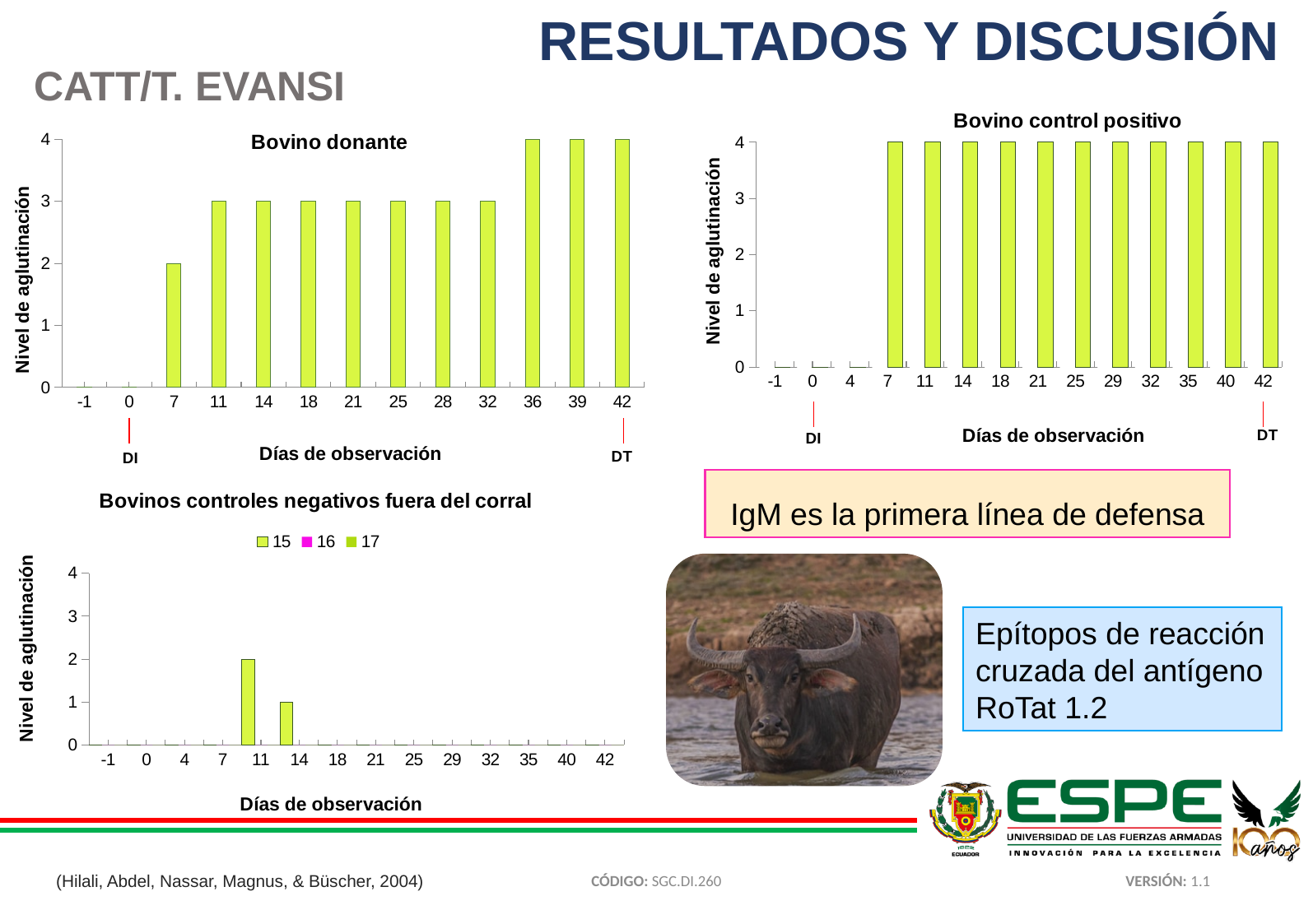
What kind of chart is 'Bovino control positivo'? Bar chart How many series does the legend of the 'Bovinos controles negativos fuera del corral' chart list? 3 In the 'Bovino donante' chart, do the agglutination levels rise or fall over the observation days? Rise In the 'Bovino control positivo' chart, what is the agglutination level on day 4? 0 In the 'Bovinos controles negativos fuera del corral' chart, what is the agglutination level on day 11? 2 In the 'Bovino donante' chart, which is higher: the value on day 11 or the value on day 39? Day 39 In the 'Bovino control positivo' chart, what is the agglutination level on day 7? 4 In the 'Bovinos controles negativos fuera del corral' chart, on which day is the agglutination level highest? Day 11 In the 'Bovino donante' chart, what is the difference between the agglutination level on day 42 and on day 7? 2 In the 'Bovino donante' chart, how many observation days are shown on the x axis? 13 In the 'Bovino donante' chart, what is the agglutination level on day 36? 4 In the 'Bovino donante' chart, what is the agglutination level on day 7? 2